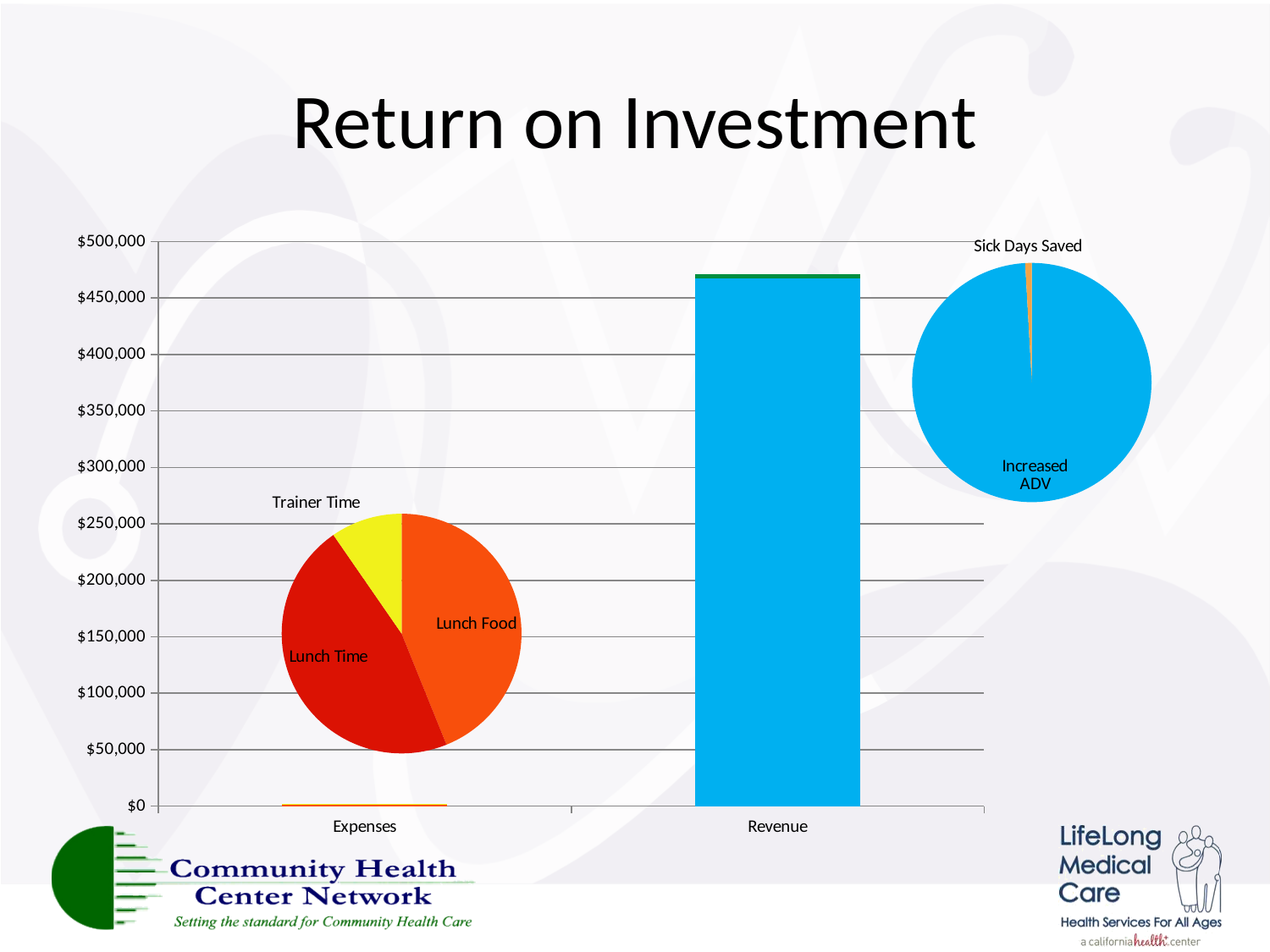
In the bar chart, is the value for Expenses greater or less than $50,000? less What kind of chart is the small chart showing Lunch Time, Lunch Food and Trainer Time? pie chart In the bar chart, is the value for Revenue greater or less than $400,000? greater In the pie chart showing Lunch Time, Lunch Food and Trainer Time, which slice is the smallest? Trainer Time How many categories are shown on the x axis of the bar chart? 2 What is the title of the slide containing the charts? Return on Investment In the pie chart showing Increased ADV and Sick Days Saved, which slice is the largest? Increased ADV In the bar chart, which category has the highest bar? Revenue In the bar chart, which category has the lowest bar? Expenses In the bar chart, is the value for Revenue greater or less than $500,000? less What kind of chart is the large chart with the Expenses and Revenue categories? bar chart In the bar chart, which category has the higher bar, Expenses or Revenue? Revenue